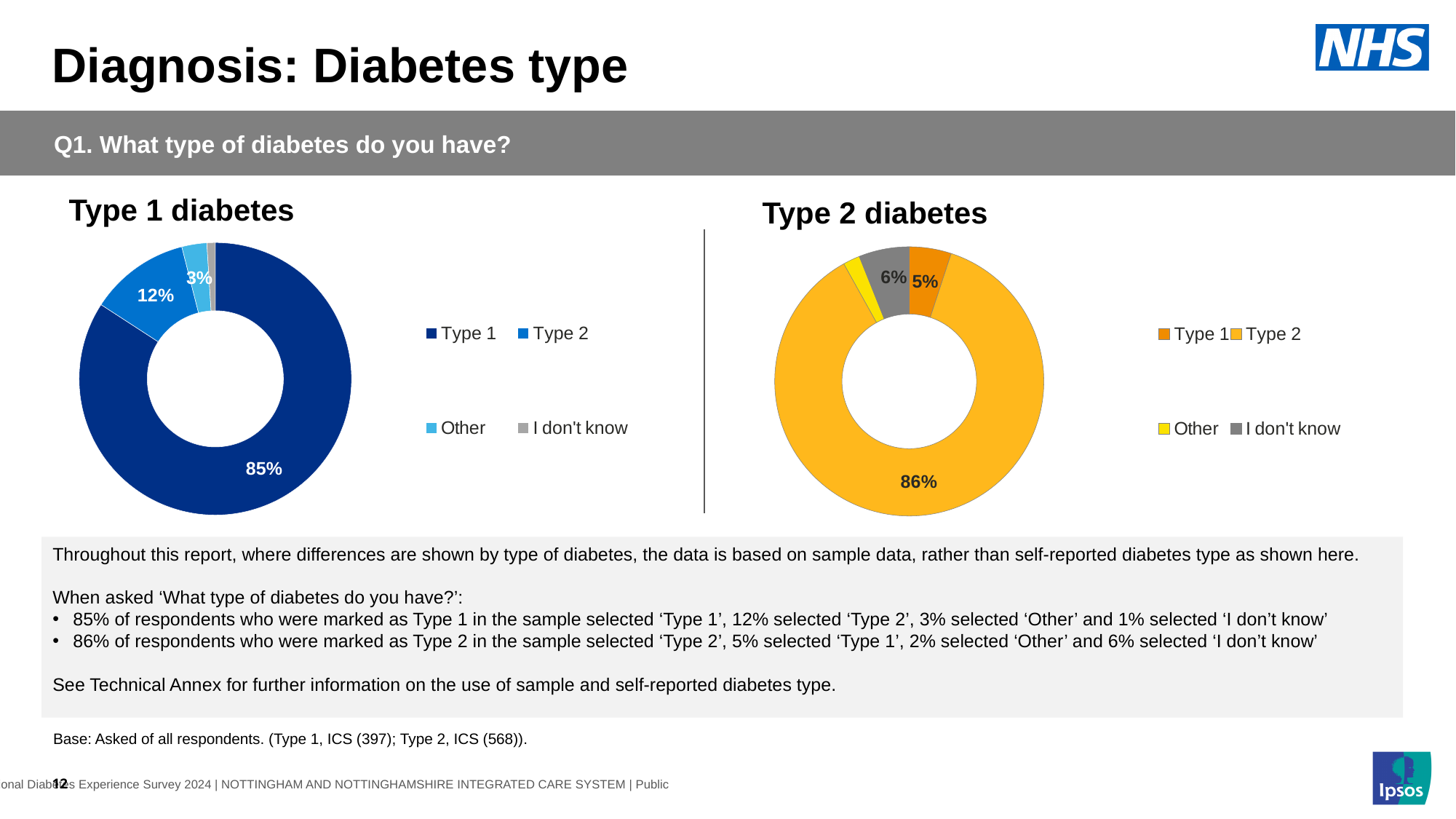
In the Type 2 diabetes chart, what percentage selected 'Type 2'? 86% In the Type 2 diabetes chart, which is larger: 'I don't know' or 'Type 1'? I don't know In the Type 2 diabetes chart, which category has the largest share? Type 2 How many categories does the legend of the Type 2 diabetes chart list? 4 In the Type 1 diabetes chart, what percentage selected 'Type 2'? 12% In the Type 1 diabetes chart, which category has the largest share? Type 1 In the Type 2 diabetes chart, what percentage selected 'Type 1'? 5% In the Type 1 diabetes chart, what percentage selected 'Other'? 3% In the Type 1 diabetes chart, what percentage selected 'Type 1'? 85% In the Type 2 diabetes chart, what percentage selected 'I don't know'? 6% In the Type 1 diabetes chart, what is the difference in percentage points between 'Type 1' and 'Type 2'? 73 percentage points In the Type 1 diabetes chart, which category has the smallest share? I don't know